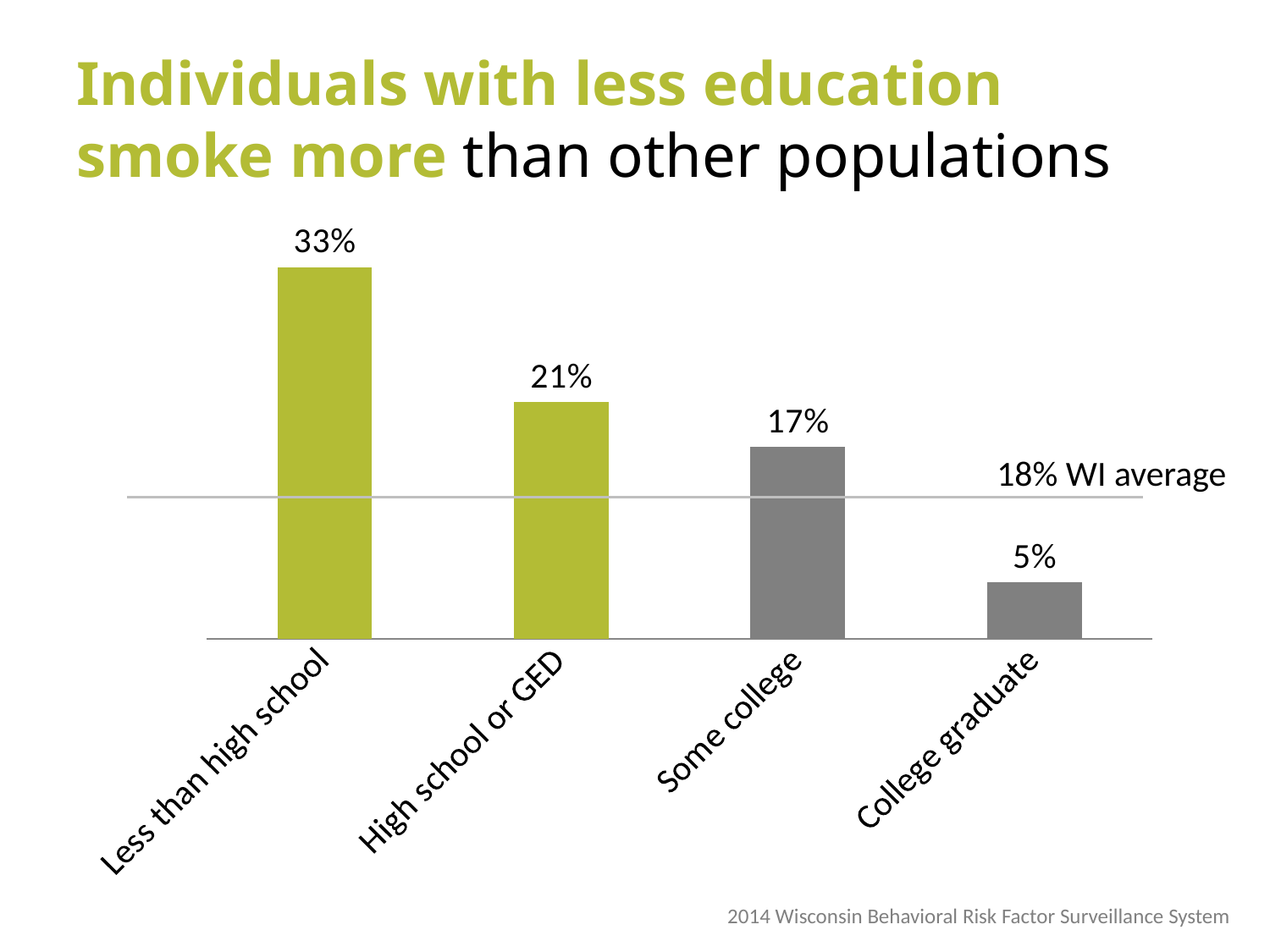
What is the smoking rate for individuals with less than high school education? 33% Which education category has the lowest smoking rate? College graduate What is the value for the High school or GED category? 21% Which is larger, the value for High school or GED or the value for Some college? High school or GED Do the values rise or fall moving from left to right across the categories? Fall What is the value for College graduate? 5% What kind of chart is shown on the slide? Bar chart What is the value for Some college? 17% What value does the horizontal reference line on the chart represent? 18% WI average What is the difference between the Less than high school and College graduate values? 28% How many education categories are shown in the chart? 4 Which education category has the highest smoking rate? Less than high school